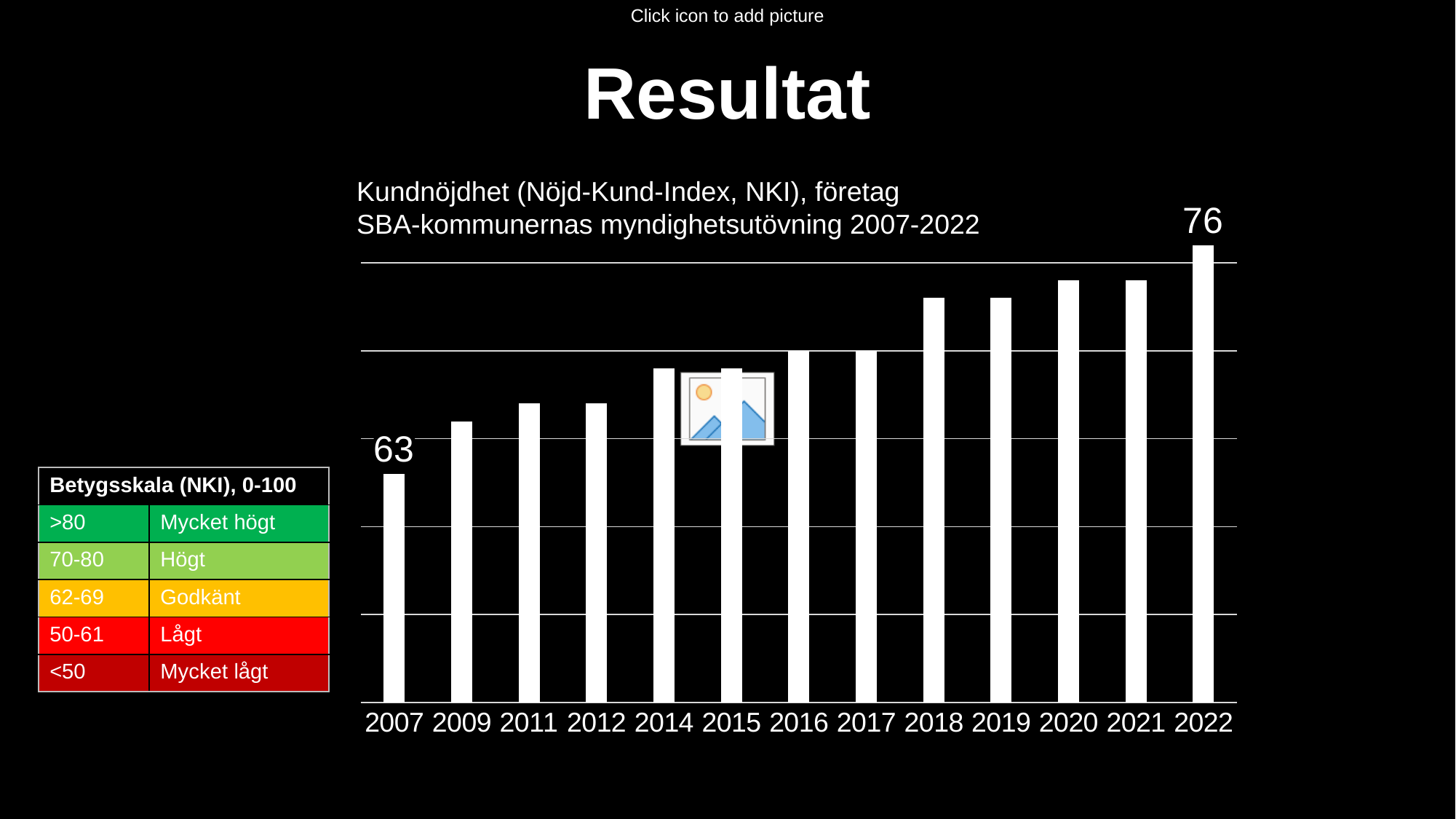
How many years are shown on the x axis? 13 What is the title of the chart? Kundnöjdhet (Nöjd-Kund-Index, NKI), företag SBA-kommunernas myndighetsutövning 2007-2022 What is the difference between the values for 2022 and 2007? 13 Which is larger, the value for 2014 or the value for 2012? 2014 Do the values generally rise or fall from 2007 to 2022? Rise What is the value for 2007? 63 Which is larger, the value for 2018 or the value for 2016? 2018 Which year has the lowest value? 2007 What is the value for 2022? 76 What kind of chart is shown? Bar chart Which year has the highest value? 2022 Which is larger, the value for 2011 or the value for 2009? 2011